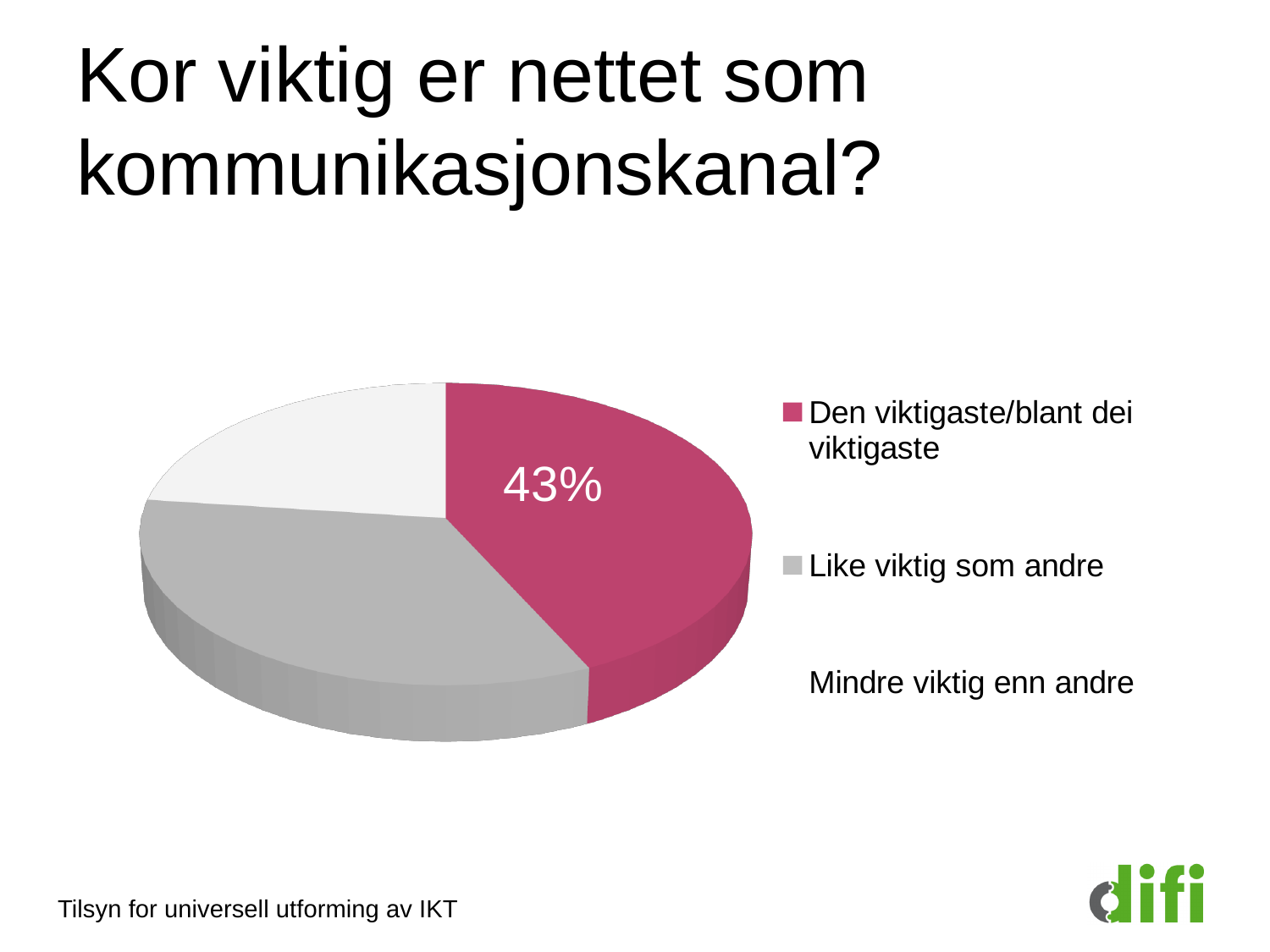
What kind of chart is shown on the slide? Pie chart What percentage of the pie is labelled for "Den viktigaste/blant dei viktigaste"? 43% How many slices does the pie chart have? 3 Which legend entry is listed second? Like viktig som andre Which slice is larger: "Like viktig som andre" or "Mindre viktig enn andre"? Like viktig som andre What colour is the slice for "Den viktigaste/blant dei viktigaste"? Magenta/pink Which slice is larger: "Den viktigaste/blant dei viktigaste" or "Mindre viktig enn andre"? Den viktigaste/blant dei viktigaste How many entries does the legend list? 3 Which category has the smallest slice of the pie? Mindre viktig enn andre What share of the pie does the "Den viktigaste/blant dei viktigaste" slice represent? 43%